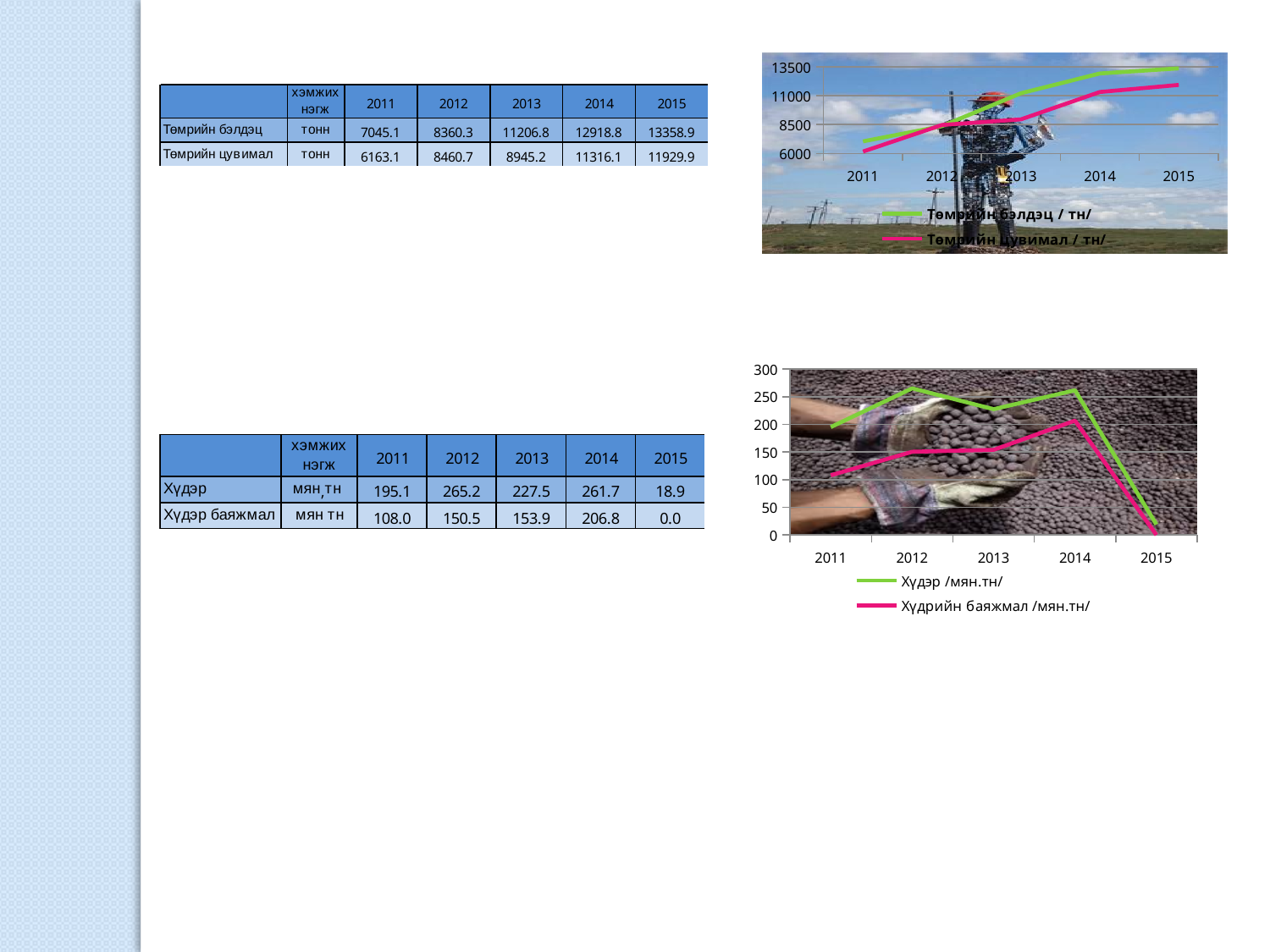
In the top-right chart, is the value for Төмрийн цувимал in 2011 greater or less than 8500? less How many years are shown on the x axis of the top-right chart? 5 According to the table for the top-right chart, what is the value of Төмрийн бэлдэц in 2014? 12918.8 What kind of chart is the top-right chart (Төмрийн бэлдэц / Төмрийн цувимал)? line chart In the top-right chart, which series has the higher value in 2013, Төмрийн бэлдэц or Төмрийн цувимал? Төмрийн бэлдэц In the top-right chart, is the value for Төмрийн бэлдэц in 2015 greater or less than 11000? greater What kind of chart is the bottom-right chart (Хүдэр / Хүдрийн баяжмал)? line chart How many series does the legend of the top-right chart list? 2 In the bottom-right chart, which year has the lowest value for Хүдэр? 2015 In the bottom-right chart, is the value for Хүдэр in 2012 greater or less than 250? greater In the bottom-right chart, does the Хүдэр line rise or fall from 2014 to 2015? falls In the top-right chart, does the Төмрийн бэлдэц line rise or fall from 2011 to 2015? rises